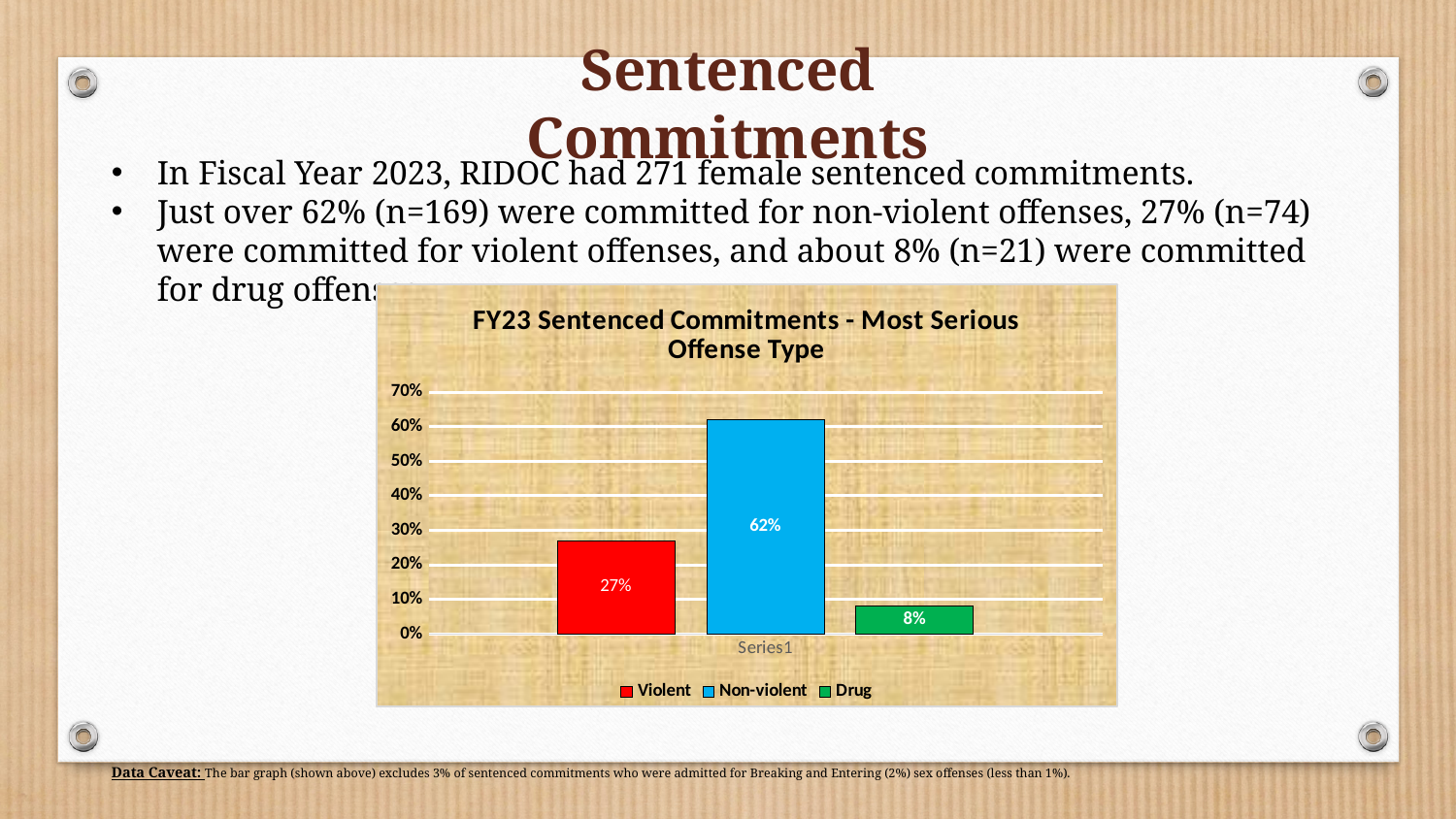
What is the value for Drug in the chart? 8% What is the difference between the Violent and Drug values? 19% What kind of chart is shown on the slide? Bar chart Is the value for Non-violent greater or less than 50%? greater Which offense type has the highest value in the chart? Non-violent What is the difference between the Non-violent and Violent values? 35% What is the value for Violent in the chart? 27% How many series does the legend list? 3 What is the title of the chart? FY23 Sentenced Commitments - Most Serious Offense Type Which is larger, the value for Violent or the value for Drug? Violent Which offense type has the lowest value in the chart? Drug What is the value for Non-violent in the chart? 62%